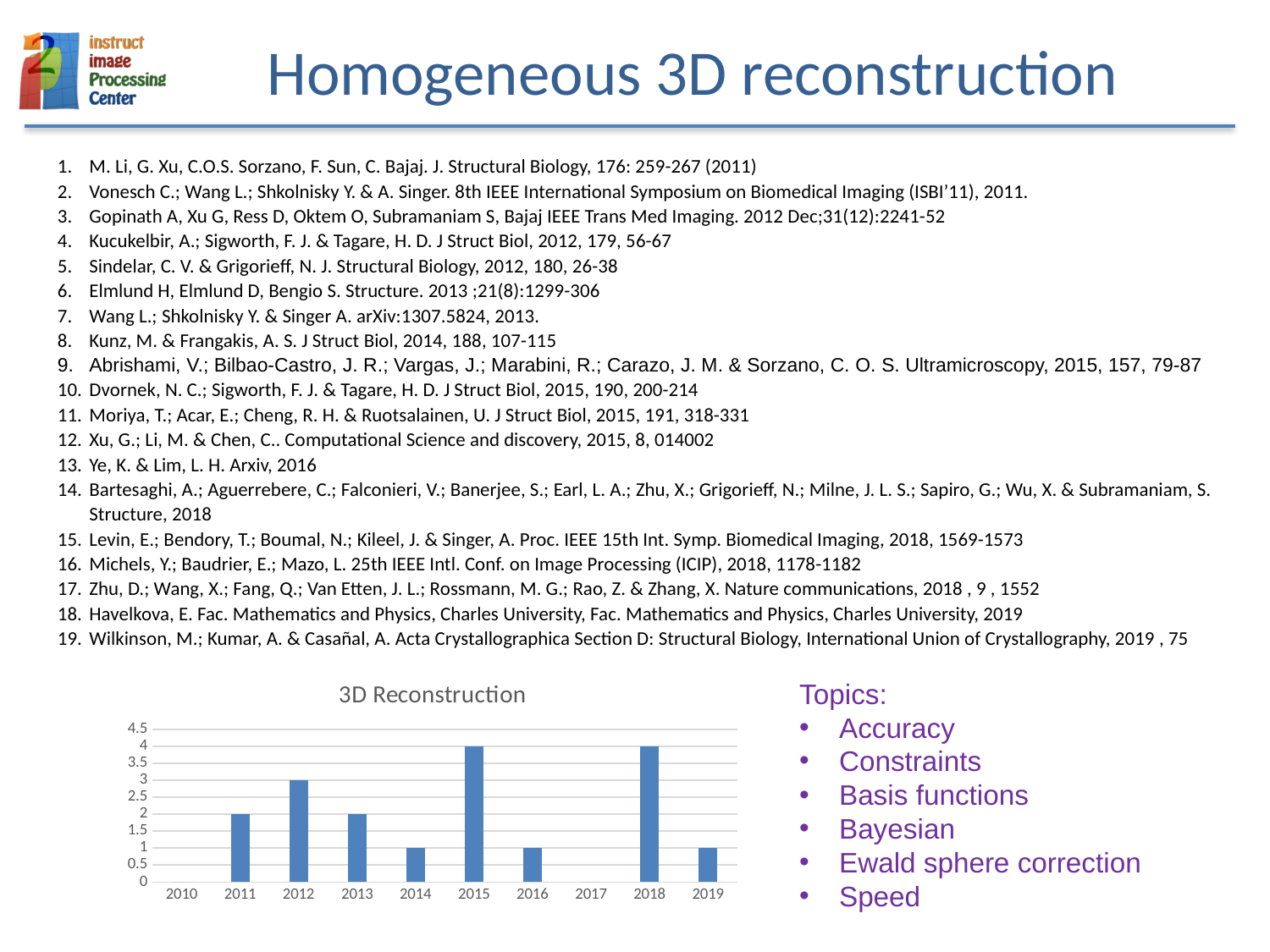
What is the value for 2014 in the 3D Reconstruction chart? 1 What is the difference between the values for 2015 and 2012 in the 3D Reconstruction chart? 1 Which two years have the highest value in the 3D Reconstruction chart? 2015 and 2018 What is the title of the chart on the slide? 3D Reconstruction Which year has the larger value in the 3D Reconstruction chart, 2012 or 2013? 2012 How many years are shown on the x axis of the chart? 10 What kind of chart is shown on the slide? bar chart Which years have no bar (a value of 0) in the 3D Reconstruction chart? 2010 and 2017 What is the value for 2015 in the 3D Reconstruction chart? 4 What is the value for 2011 in the 3D Reconstruction chart? 2 What is the value for 2012 in the 3D Reconstruction chart? 3 Is the value for 2018 in the 3D Reconstruction chart greater or less than 3? greater